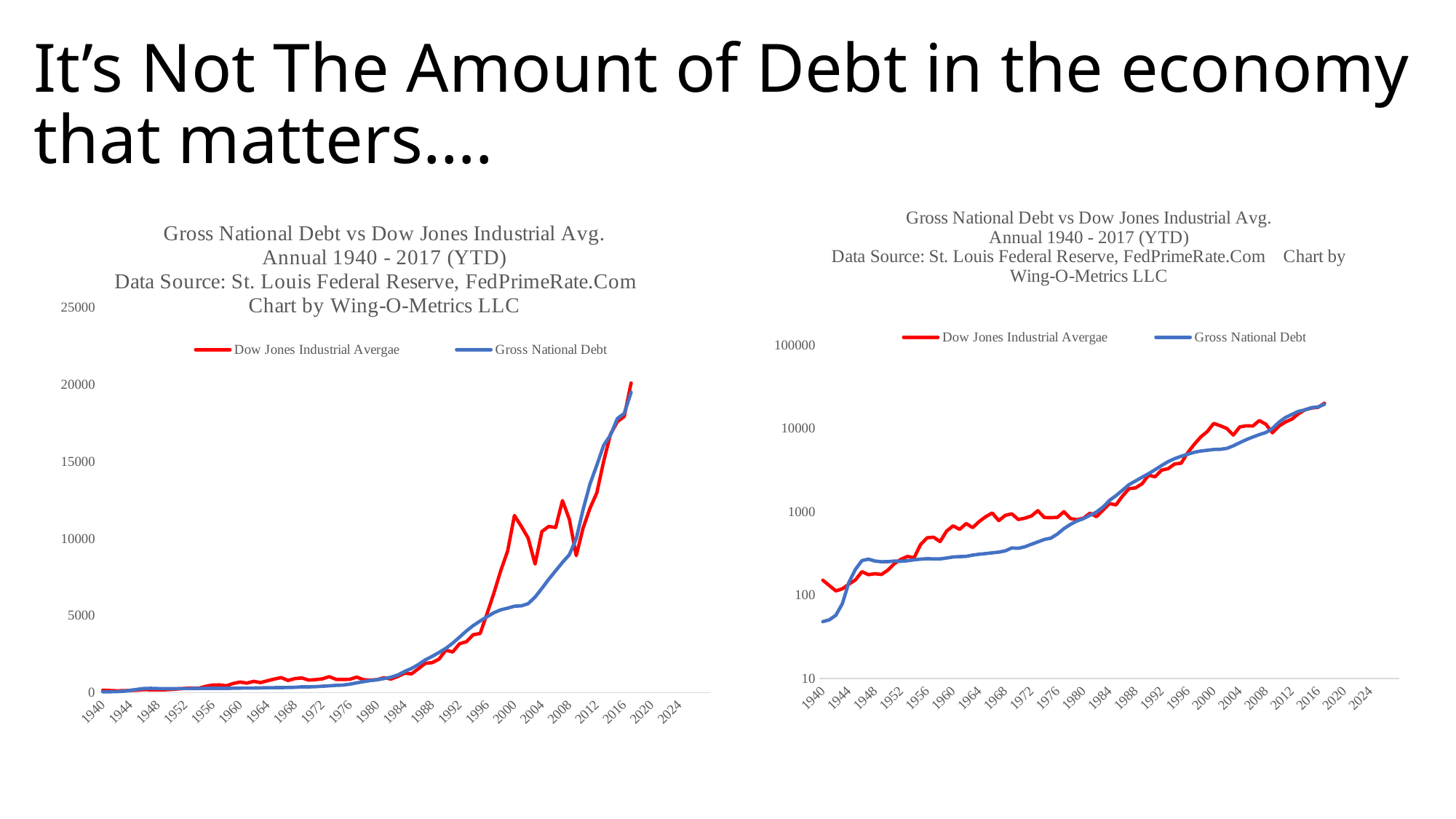
What colour is the Gross National Debt line in the right chart? Blue In the right chart, is the Gross National Debt value around 1960 greater or less than 1000? less In the left chart, is the Gross National Debt value around 2016 greater or less than 15000? greater In the right chart, is the Dow Jones Industrial Average value in 1940 greater or less than 100? greater What type of chart is the left chart on the slide? Line chart In the left chart, does the Gross National Debt line generally rise or fall from 1940 to 2016? Rise According to the chart titles, what years do the charts cover? 1940 - 2017 (YTD) In the left chart, around 2000, which series has the larger value: Dow Jones Industrial Average or Gross National Debt? Dow Jones Industrial Average How many series does the legend of the left chart list? 2